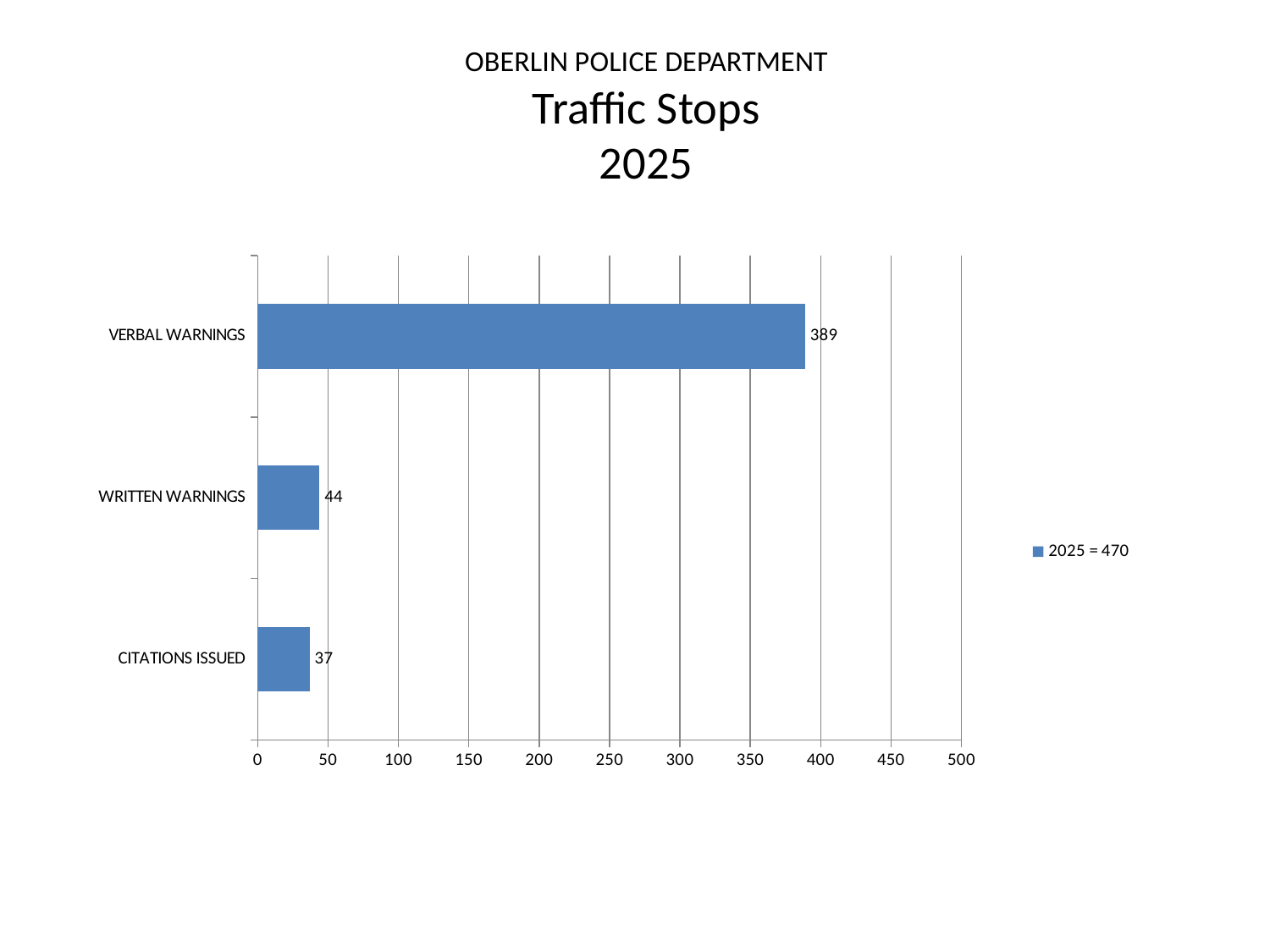
What is the value for WRITTEN WARNINGS? 44 Is the value for VERBAL WARNINGS greater or less than 350? greater What kind of chart is shown on the slide? bar chart What is the value for CITATIONS ISSUED? 37 What is the difference between VERBAL WARNINGS and WRITTEN WARNINGS? 345 What does the legend entry say? 2025 = 470 Which is larger, VERBAL WARNINGS or CITATIONS ISSUED? VERBAL WARNINGS Which category has the lowest value? CITATIONS ISSUED How many categories are shown in the chart? 3 What is the value for VERBAL WARNINGS? 389 What is the difference between WRITTEN WARNINGS and CITATIONS ISSUED? 7 Which category has the highest value? VERBAL WARNINGS